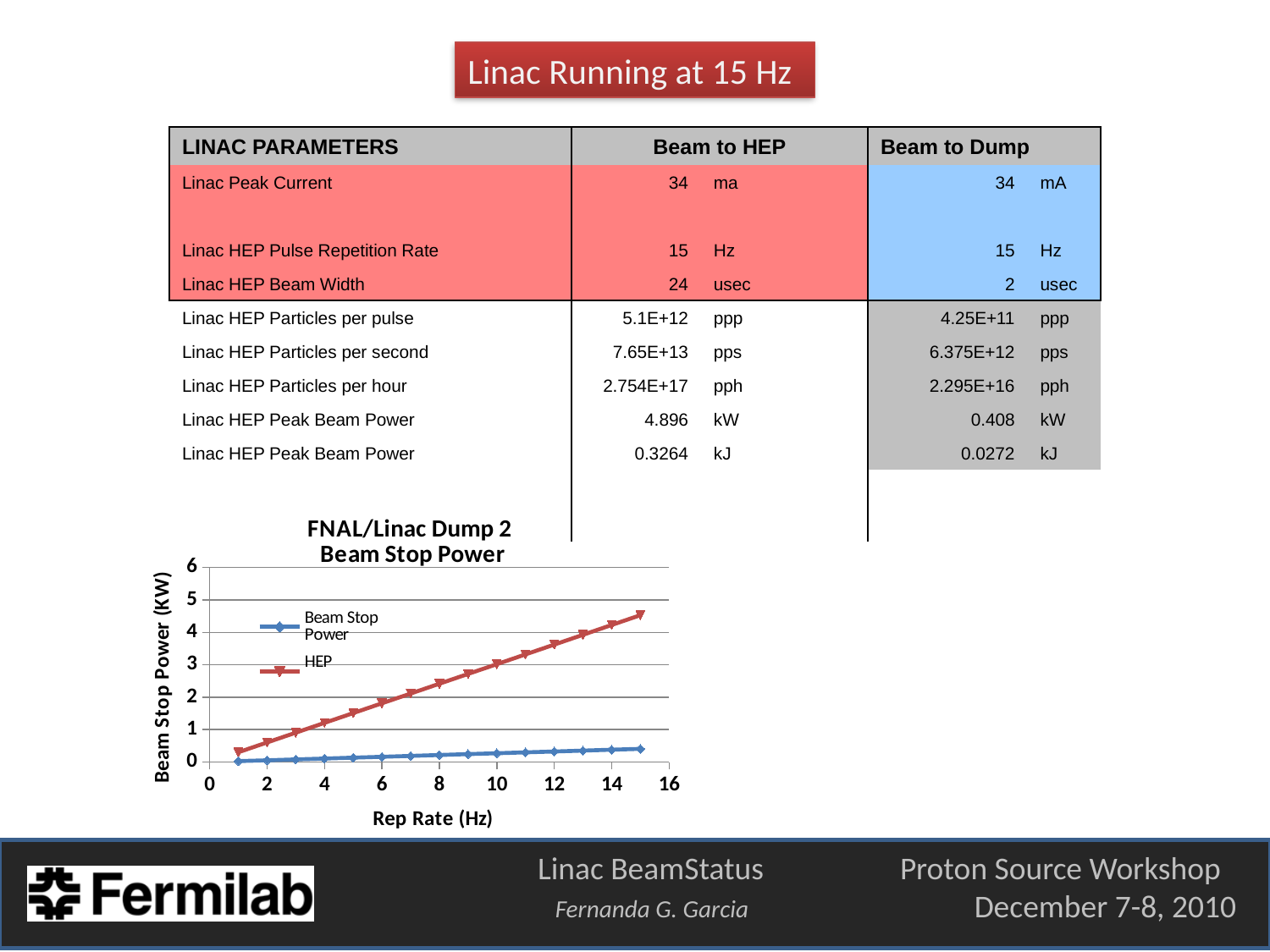
What is the label of the x axis of the chart? Rep Rate (Hz) Is the HEP value at 15 Hz greater or less than 4? greater At 15 Hz, which series has the larger value, HEP or Beam Stop Power? HEP Does the Beam Stop Power series rise or fall as Rep Rate increases? rise How many series does the legend of the chart list? 2 Is the Beam Stop Power value at 15 Hz greater or less than 1? less Is the HEP value at 2 Hz greater or less than 1? less What kind of chart is shown on the slide? line chart Does the HEP series rise or fall as Rep Rate increases? rise What is the title of the chart? FNAL/Linac Dump 2 Beam Stop Power Which series reaches the highest value on the chart? HEP